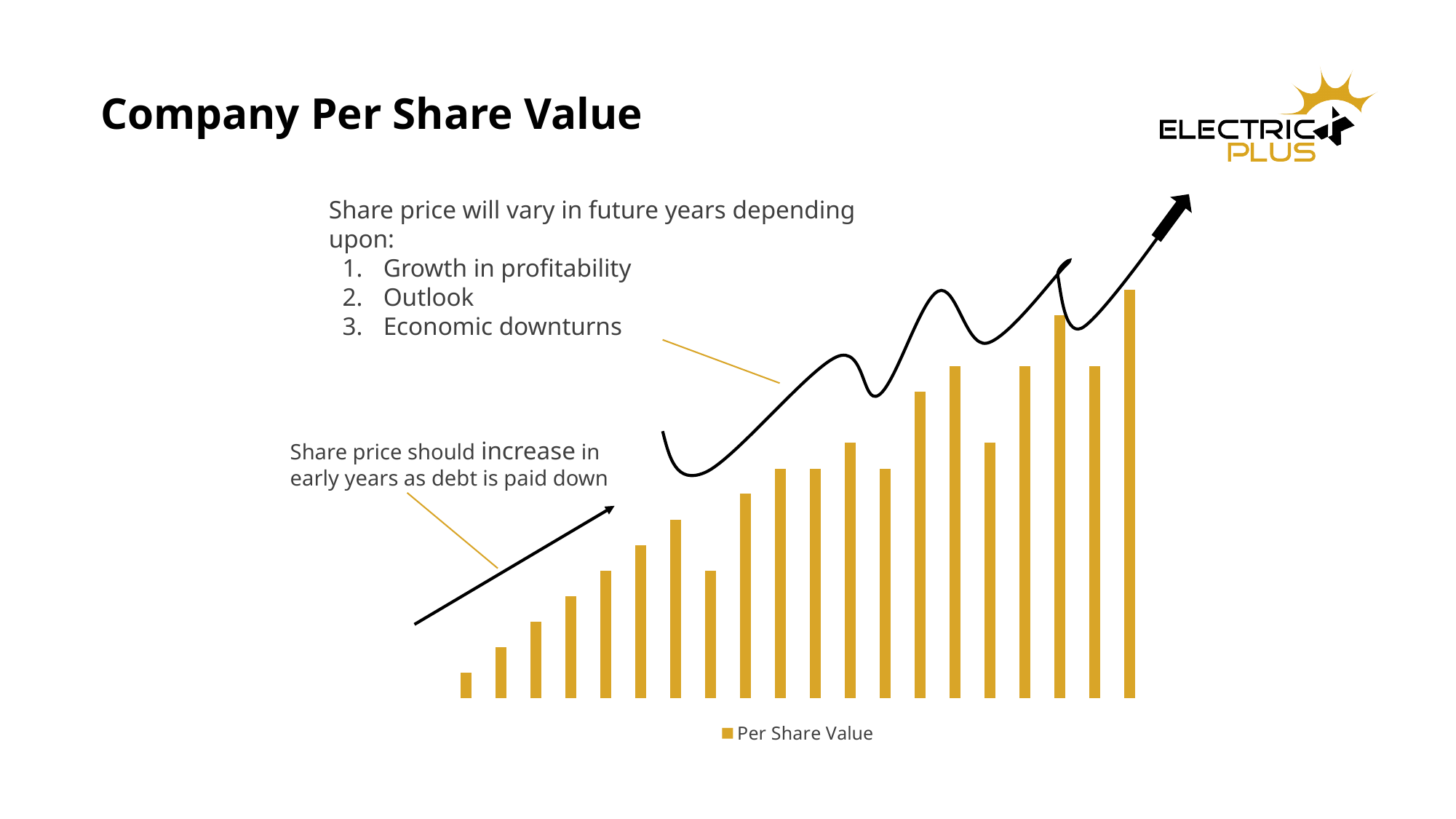
Do the bar values generally rise or fall from left to right across the chart? rise Which bar in the chart is the shortest? the leftmost (first) bar How many bars are plotted in the chart? 20 What kind of chart is shown on the slide? bar chart Is the last bar taller or shorter than the bar immediately before it? taller What is the name of the series shown in the chart legend? Per Share Value What colour are the bars in the chart? gold Is the rightmost bar taller or shorter than the leftmost bar? taller Which bar in the chart is the tallest? the rightmost (last) bar How many series does the chart legend list? 1